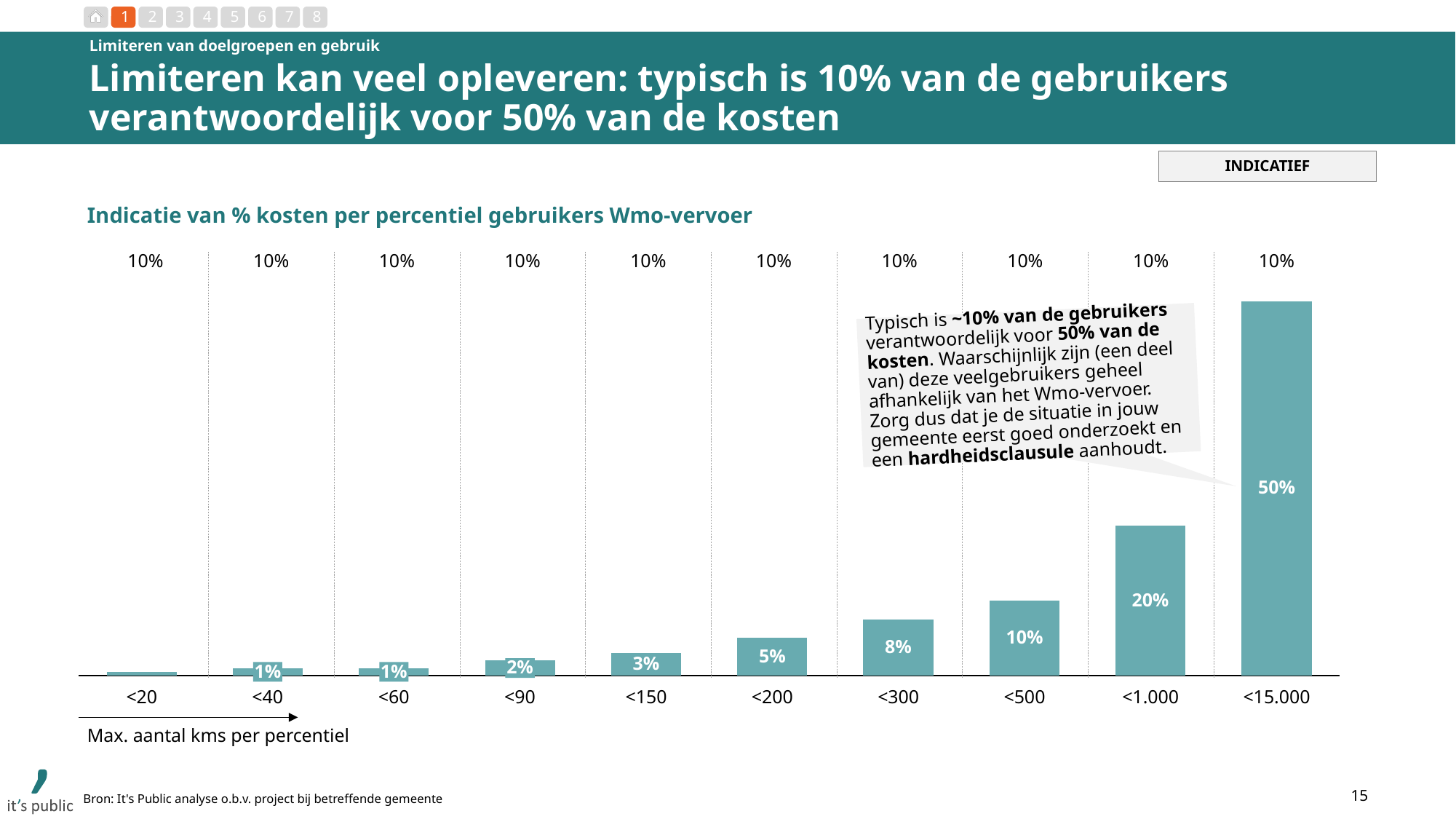
Do the percentage-of-cost values rise or fall from left to right along the x axis? Rise What percentage of costs is shown for the <300 category? 8% Which category has the highest percentage of costs? <15.000 What percentage of costs is shown for the <15.000 category? 50% How many categories are shown on the x axis of the chart? 10 What is the difference in percentage of costs between the <15.000 and <1.000 categories? 30 percentage points Which has a higher percentage of costs, <500 or <200? <500 What is the x-axis label of the chart? Max. aantal kms per percentiel What kind of chart is shown on the slide? Bar chart What percentage of costs is shown for the <150 category? 3% What is the title of the chart? Indicatie van % kosten per percentiel gebruikers Wmo-vervoer What percentage of costs is shown for the <1.000 category? 20%